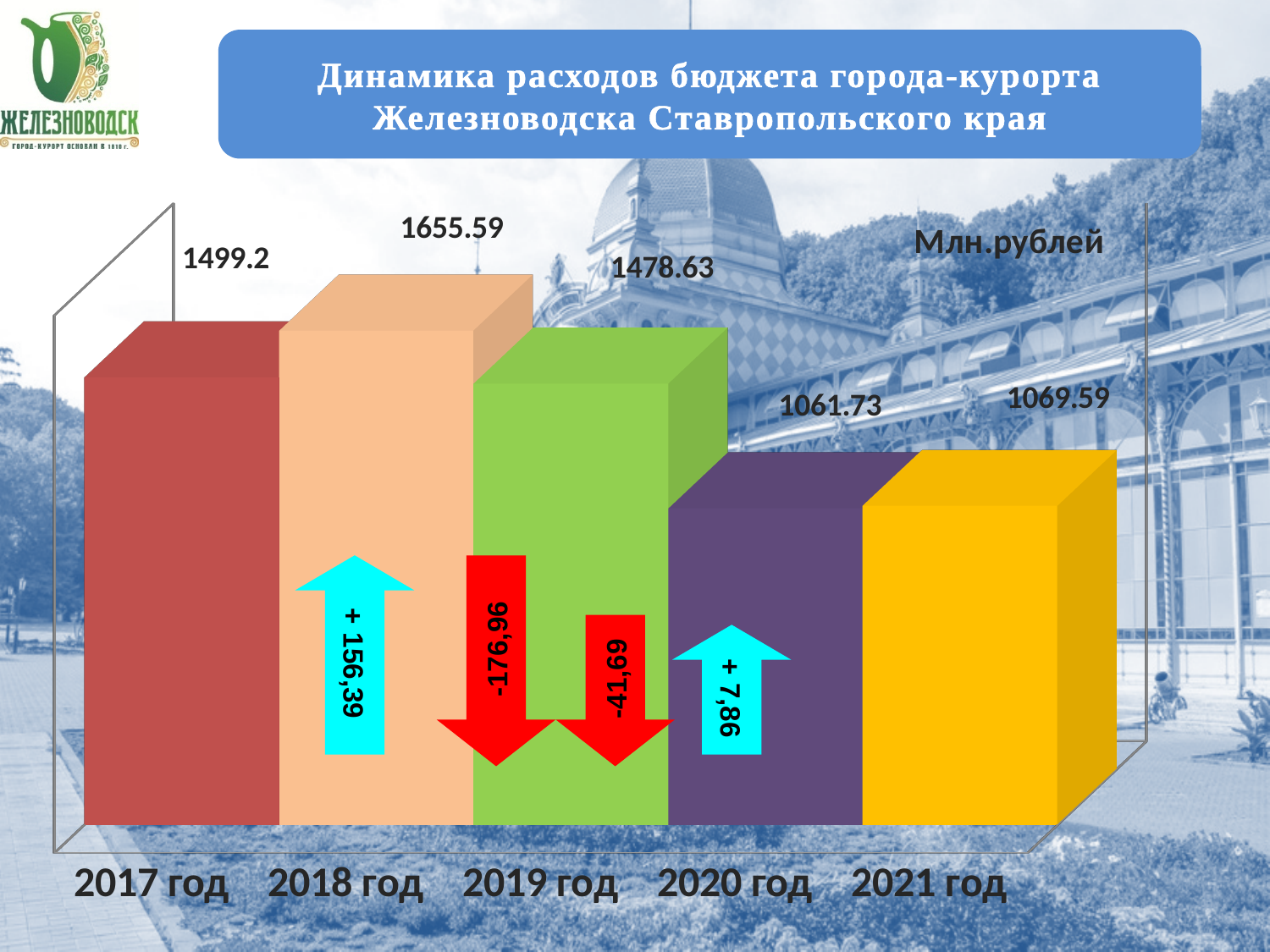
What is the value shown for 2021 год? 1069.59 What is the budget expenditure value shown for 2017 год? 1499.2 What is the difference between the values for 2018 год and 2019 год? 176.96 What kind of chart is shown on the slide? Bar chart Which year has the lowest budget expenditure? 2020 год Which year has the highest budget expenditure? 2018 год What is the value shown for 2020 год? 1061.73 What is the value shown for 2018 год? 1655.59 How many years are shown on the chart? 5 What unit of measurement is indicated on the chart? Млн.рублей Which is larger, the value for 2017 год or the value for 2019 год? 2017 год What change is shown by the arrow between 2020 год and 2021 год? + 7,86